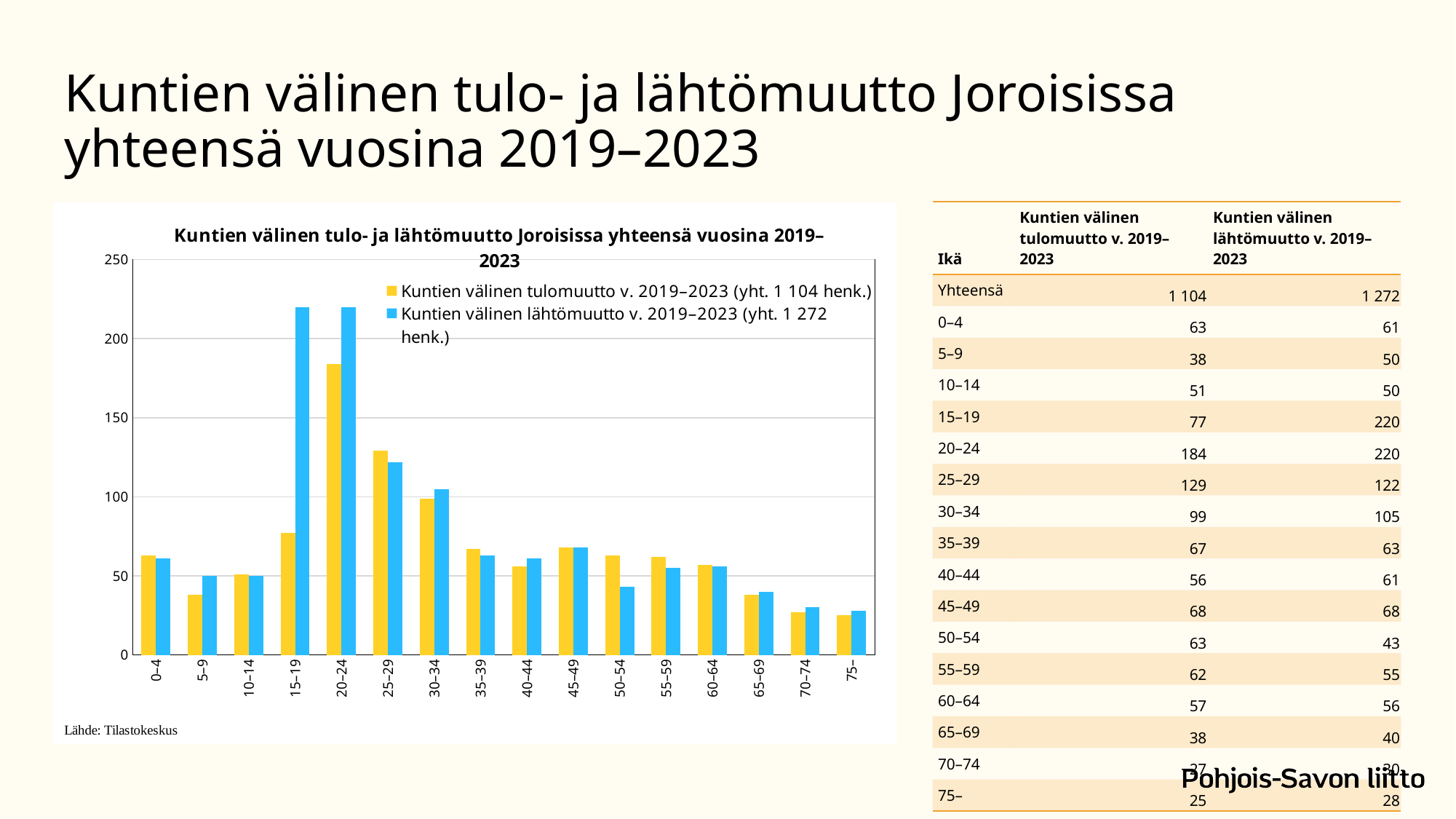
Is the value of lähtömuutto for the 15–19 age group greater or less than 200? greater Do the tulomuutto values rise or fall from the 20–24 age group to the 35–39 age group? fall What is the value of Kuntien välinen tulomuutto v. 2019–2023 for the 25–29 age group? 129 How many series does the chart legend list? 2 For the 50–54 age group, which is larger: tulomuutto or lähtömuutto? tulomuutto What is the value of Kuntien välinen lähtömuutto v. 2019–2023 for the 15–19 age group? 220 Which age group has the highest value for Kuntien välinen tulomuutto v. 2019–2023? 20–24 According to the legend, what is the total number of persons for Kuntien välinen tulomuutto v. 2019–2023? 1 104 henk. How many age groups are shown on the x axis of the chart? 16 What is the value of Kuntien välinen tulomuutto v. 2019–2023 for the 20–24 age group? 184 For the 15–19 age group, what is the difference between lähtömuutto and tulomuutto? 143 What kind of chart is shown on the slide? bar chart